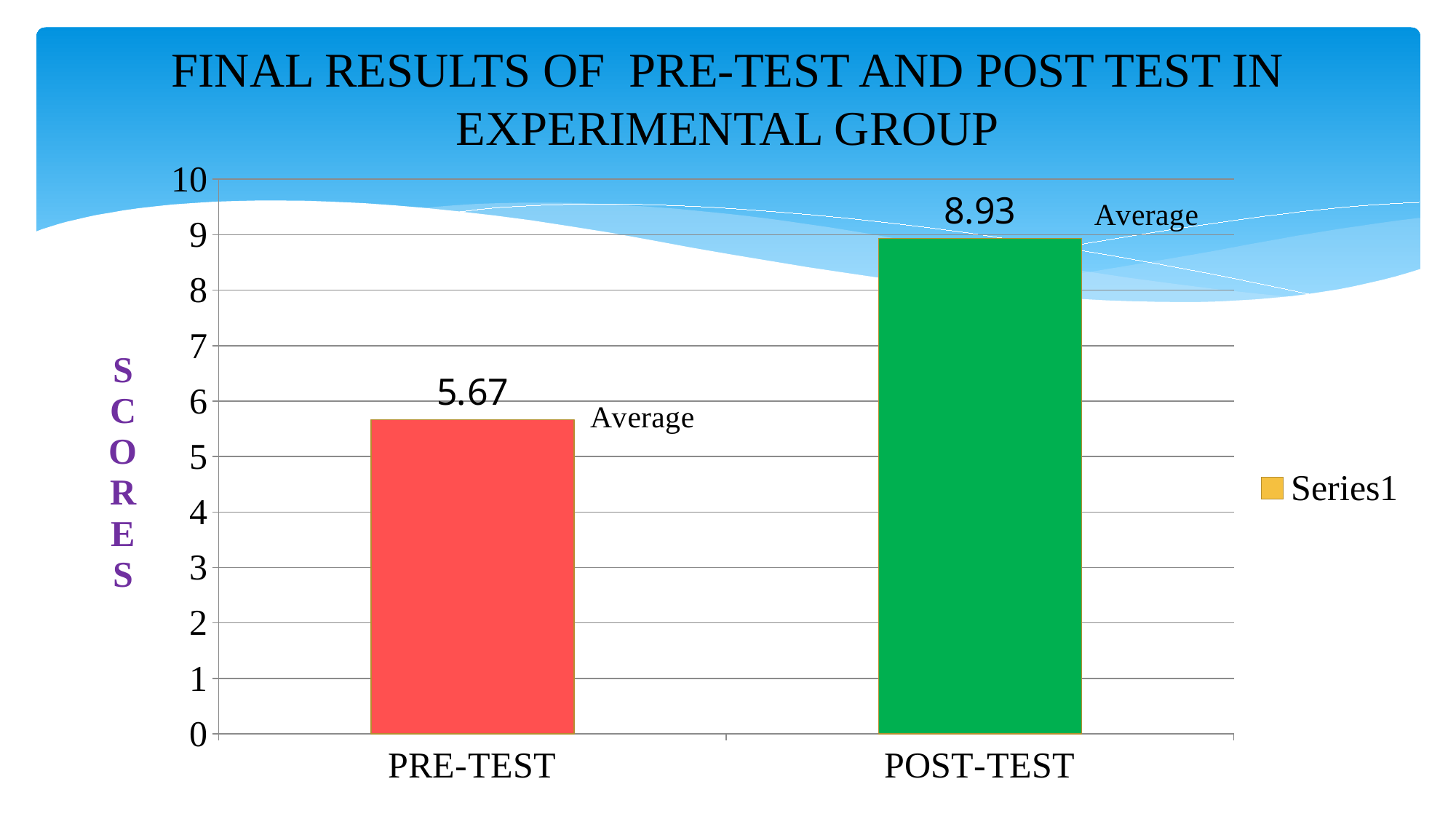
Which category has the highest value? POST-TEST Is the value for POST-TEST greater or less than 8? greater What is the difference between the POST-TEST and PRE-TEST values? 3.26 Is the value for PRE-TEST greater or less than 6? less How many categories are shown on the x axis? 2 What kind of chart is shown on the slide? bar chart Which is larger, the value for PRE-TEST or the value for POST-TEST? POST-TEST How many series does the legend list? 1 Which category has the lowest value? PRE-TEST What is the value for PRE-TEST? 5.67 What is the title of the chart? FINAL RESULTS OF PRE-TEST AND POST TEST IN EXPERIMENTAL GROUP What is the value for POST-TEST? 8.93